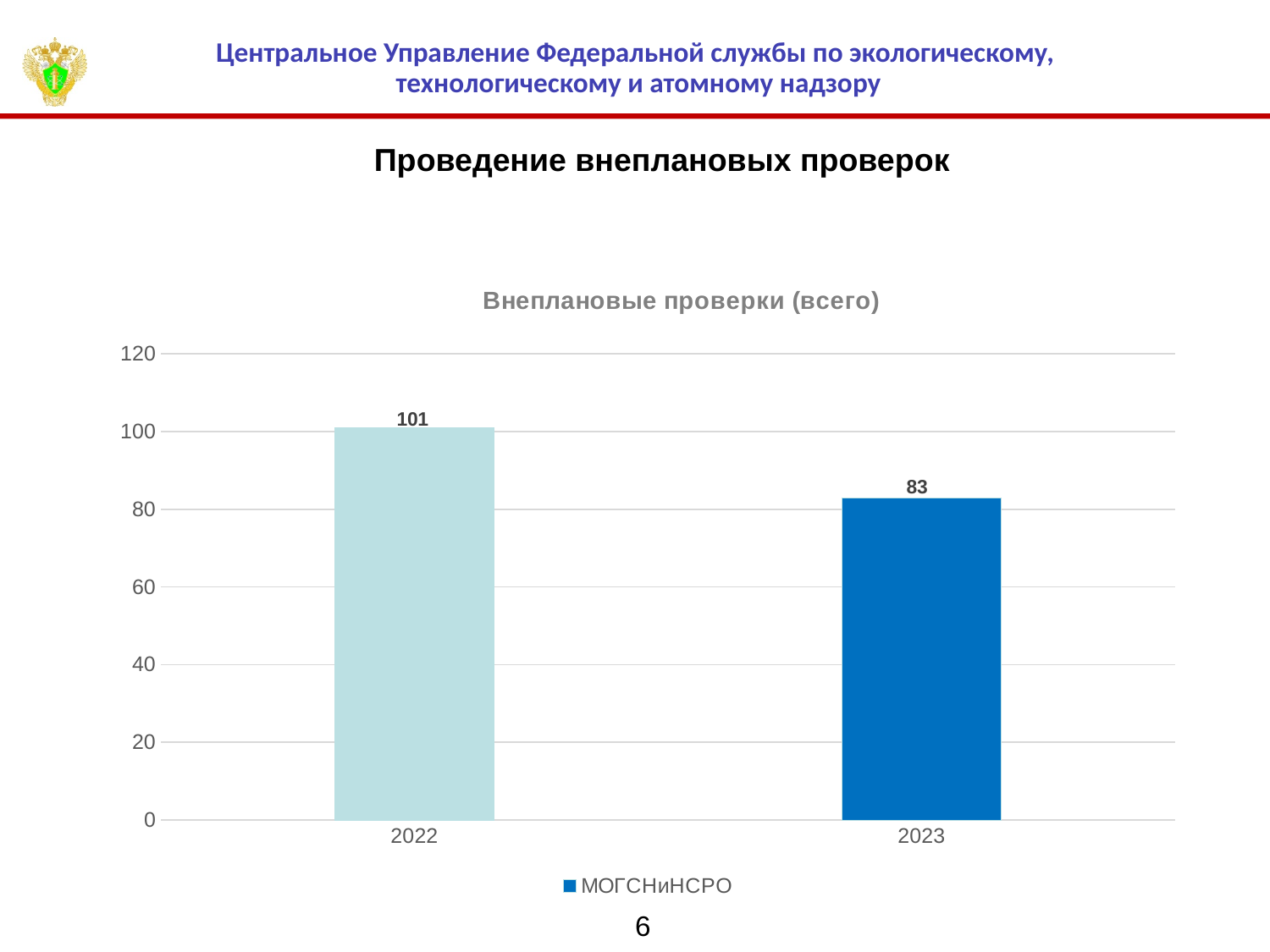
What is the title of the chart? Внеплановые проверки (всего) Which is larger, the value for 2022 or the value for 2023? 2022 Is the value for 2023 greater or less than 100? less What is the value for 2023? 83 What is the value for 2022? 101 What is the difference between the values for 2022 and 2023? 18 Which year has the lowest value? 2023 Which year has the highest value? 2022 How many categories are shown on the x axis? 2 What kind of chart is shown? bar chart How many series does the legend list? 1 Is the value for 2022 greater or less than 80? greater